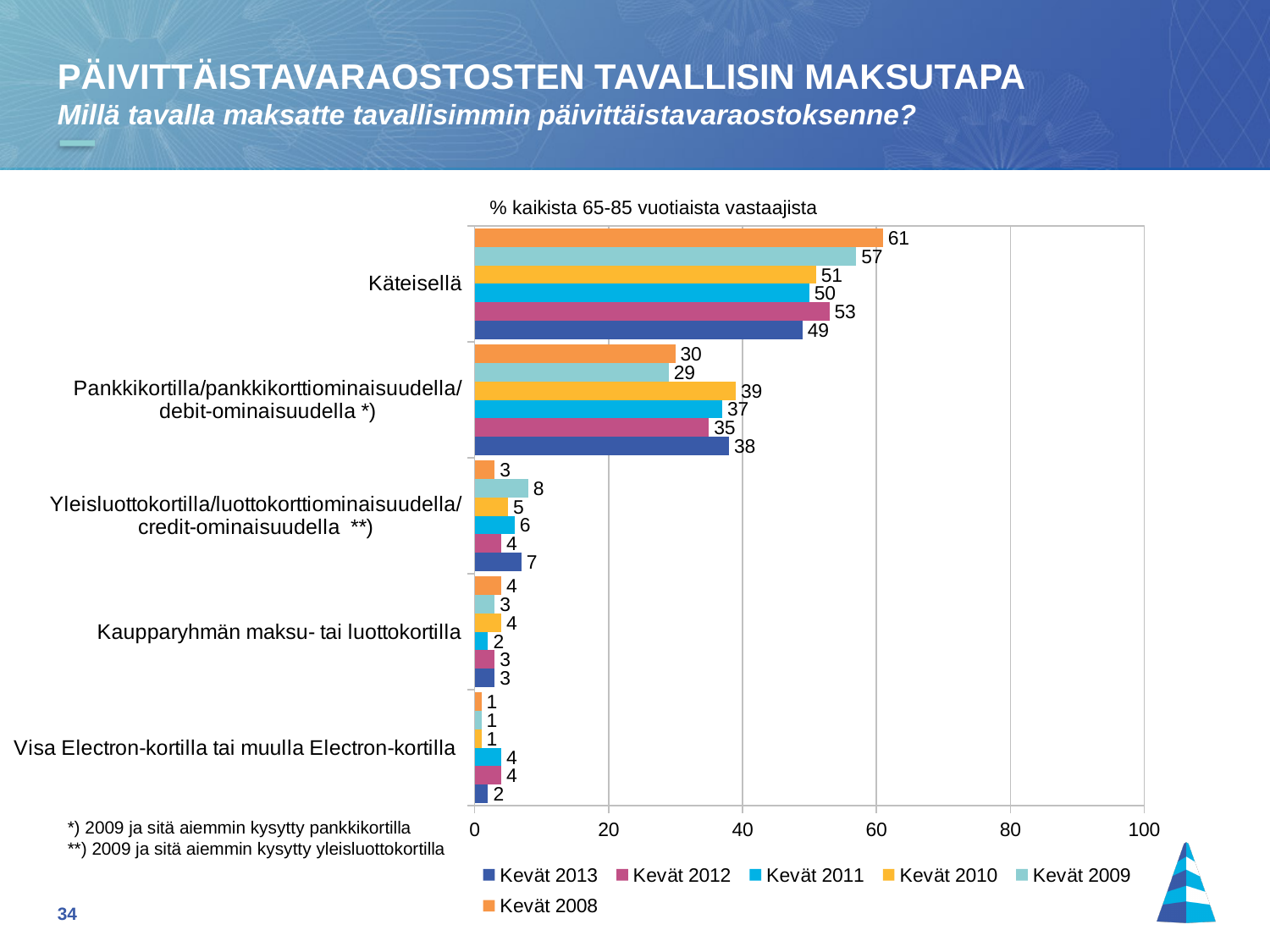
What kind of chart is shown on the slide? bar chart What is the value for Käteisellä in Kevät 2013? 49 What is the value for Käteisellä in Kevät 2008? 61 Which is larger for Pankkikortilla/pankkikorttiominaisuudella/debit-ominaisuudella: the Kevät 2013 value or the Kevät 2008 value? Kevät 2013 What is the value for Pankkikortilla/pankkikorttiominaisuudella/debit-ominaisuudella in Kevät 2010? 39 What is the value for Yleisluottokortilla/luottokorttiominaisuudella/credit-ominaisuudella in Kevät 2009? 8 What is the subtitle printed above the chart? % kaikista 65-85 vuotiaista vastaajista How many payment-method categories are shown on the chart? 5 How many series does the legend list? 6 What is the difference between the Käteisellä values for Kevät 2008 and Kevät 2013? 12 Which category has the highest value in Kevät 2013? Käteisellä Which category has the lowest value in Kevät 2008? Visa Electron-kortilla tai muulla Electron-kortilla